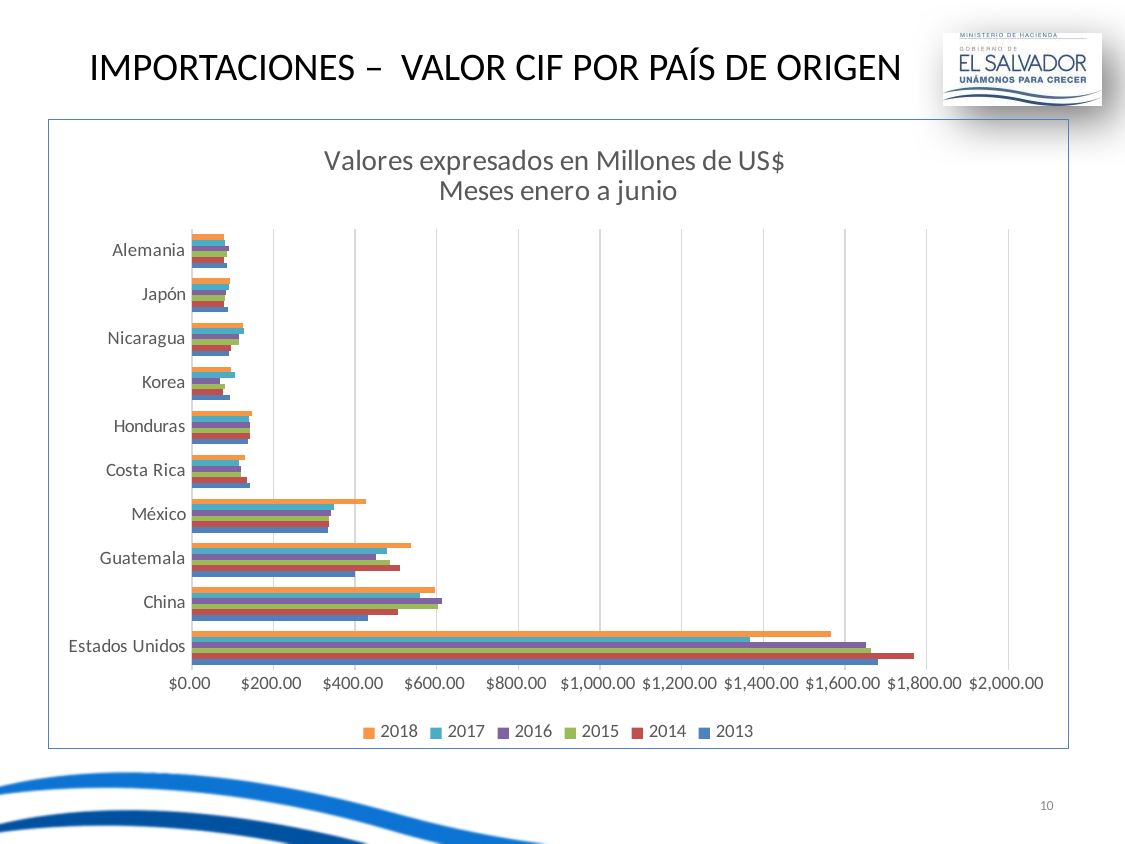
In 2018, which country has the larger value, China or Guatemala? China Which country has the highest import value in 2018? Estados Unidos What unit does the chart title say the values are expressed in? Millones de US$ How many series does the chart legend list? 6 Is the 2013 value for Guatemala greater or less than $600.00? less For Estados Unidos, which year has the larger value, 2018 or 2014? 2014 How many countries are listed on the vertical axis of the chart? 10 What kind of chart is shown on the slide? Bar chart Is the 2018 value for México greater or less than $200.00? greater Which year does the orange series in the legend represent? 2018 Is the 2018 value for Estados Unidos greater or less than $1,400.00? greater